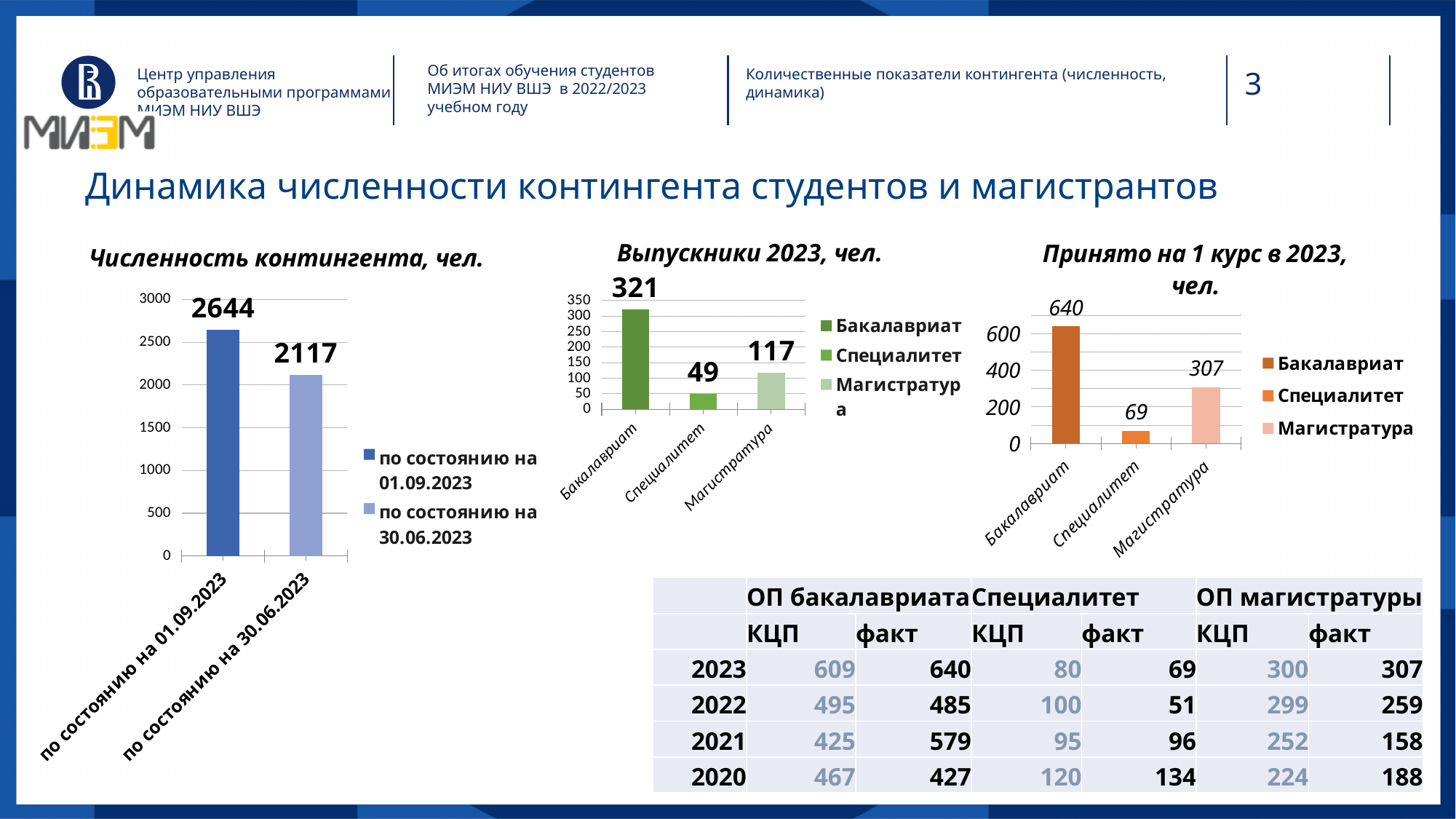
In the chart 'Выпускники 2023, чел.', what is the value for Специалитет? 49 In the chart 'Выпускники 2023, чел.', which category has the highest value? Бакалавриат In the chart 'Численность контингента, чел.', what is the value for 'по состоянию на 01.09.2023'? 2644 In the chart 'Принято на 1 курс в 2023, чел.', is the value for Бакалавриат larger or smaller than the value for Магистратура? larger In the chart 'Выпускники 2023, чел.', how many categories are shown on the x axis? 3 In the chart 'Выпускники 2023, чел.', what is the difference between Бакалавриат and Магистратура? 204 In the chart 'Численность контингента, чел.', how many series does the legend list? 2 In the chart 'Принято на 1 курс в 2023, чел.', what is the value for Магистратура? 307 What kind of chart is 'Принято на 1 курс в 2023, чел.'? bar chart In the chart 'Численность контингента, чел.', what is the value for 'по состоянию на 30.06.2023'? 2117 In the chart 'Принято на 1 курс в 2023, чел.', which category has the lowest value? Специалитет In the chart 'Численность контингента, чел.', what is the difference between the value on 01.09.2023 and the value on 30.06.2023? 527